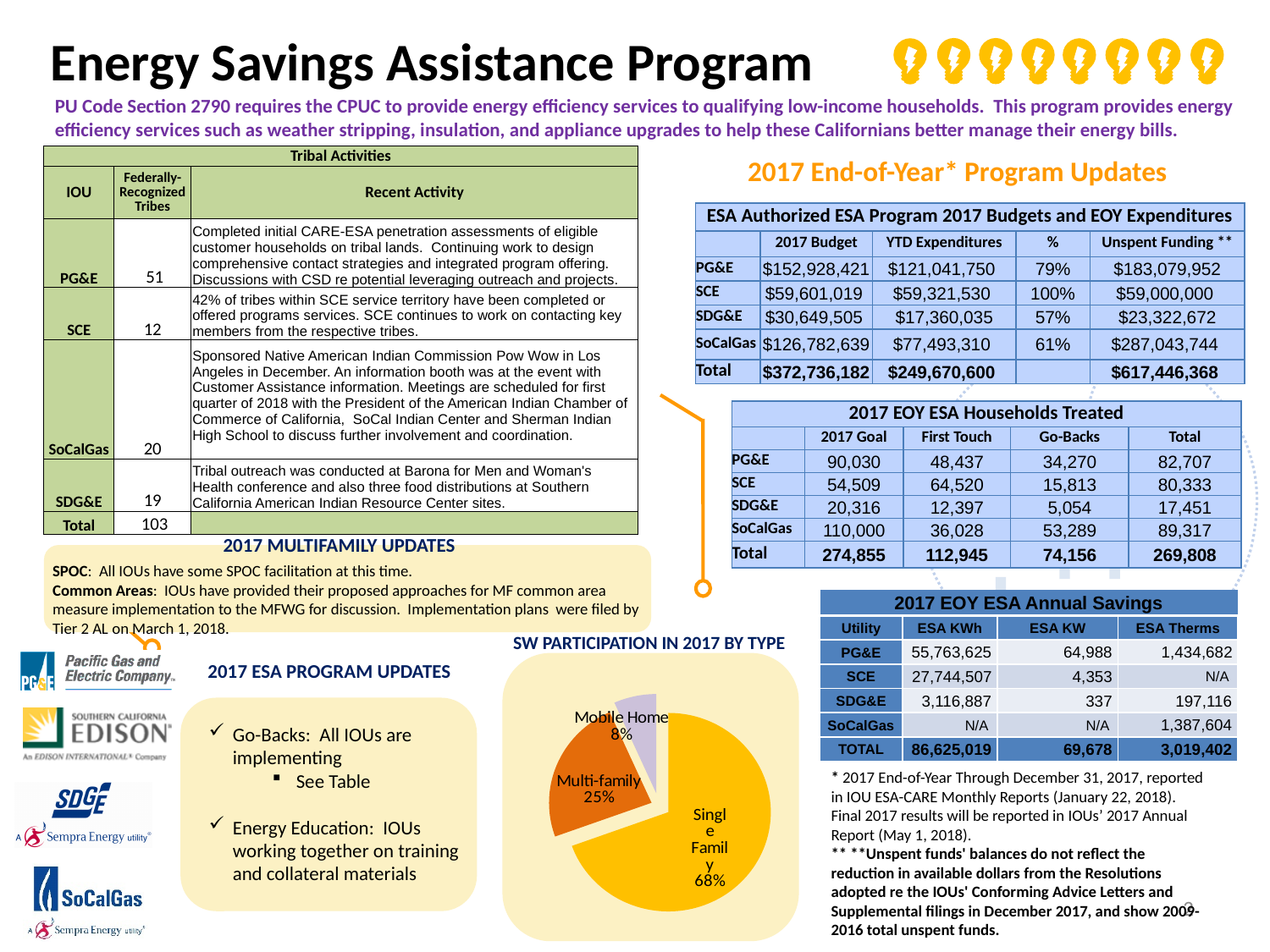
In the "SW PARTICIPATION IN 2017 BY TYPE" pie chart, which type has the smallest share? Mobile Home What is the title of the pie chart on the slide? SW PARTICIPATION IN 2017 BY TYPE In the "SW PARTICIPATION IN 2017 BY TYPE" pie chart, what percentage is shown for Multi-family? 25% In the "SW PARTICIPATION IN 2017 BY TYPE" pie chart, what percentage is shown for Single Family? 68% How many slices does the "SW PARTICIPATION IN 2017 BY TYPE" pie chart have? 3 In the "SW PARTICIPATION IN 2017 BY TYPE" pie chart, how many percentage points larger is the Multi-family share than the Mobile Home share? 17 percentage points What share of the "SW PARTICIPATION IN 2017 BY TYPE" pie does the Multi-family slice represent? 25% In the "SW PARTICIPATION IN 2017 BY TYPE" pie chart, which is larger: the Multi-family share or the Mobile Home share? Multi-family In the "SW PARTICIPATION IN 2017 BY TYPE" pie chart, how many percentage points larger is the Single Family share than the Multi-family share? 43 percentage points In the "SW PARTICIPATION IN 2017 BY TYPE" pie chart, what percentage is shown for Mobile Home? 8% What kind of chart is "SW PARTICIPATION IN 2017 BY TYPE"? pie chart In the "SW PARTICIPATION IN 2017 BY TYPE" pie chart, which type has the largest share? Single Family